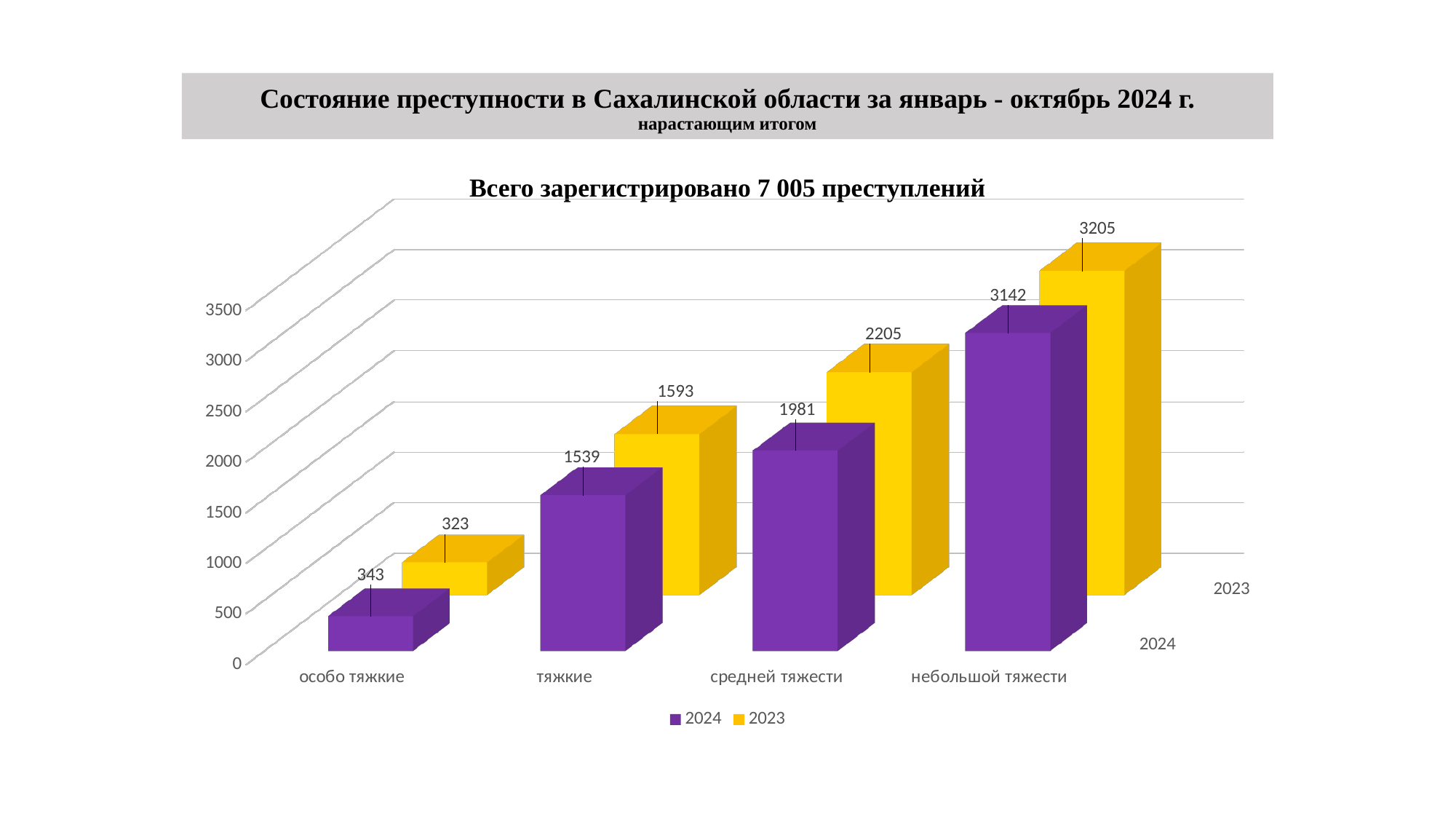
What kind of chart is shown on the slide? bar chart How many categories are shown on the x axis? 4 What is the value for 'особо тяжкие' in the 2024 series? 343 What is the chart's title? Всего зарегистрировано 7 005 преступлений What is the value for 'небольшой тяжести' in the 2023 series? 3205 Which is larger for 'особо тяжкие': the 2024 value or the 2023 value? 2024 Which category has the highest value in the 2024 series? небольшой тяжести What is the difference between the 2023 and 2024 values for 'тяжкие'? 54 Which category has the lowest value in the 2023 series? особо тяжкие How many series does the legend list? 2 Which is larger for 'средней тяжести': the 2024 value or the 2023 value? 2023 What is the value for 'средней тяжести' in the 2024 series? 1981